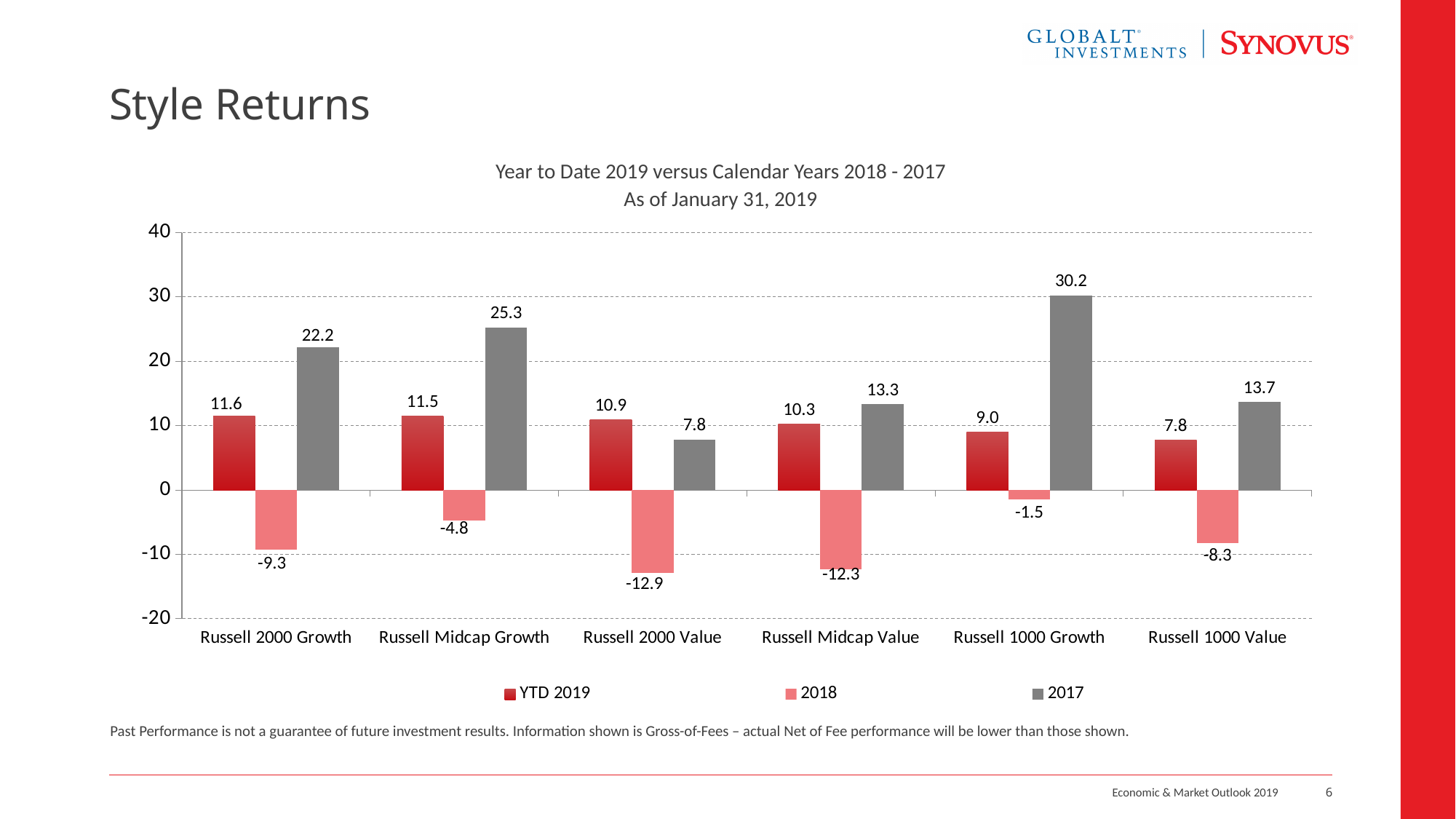
How many categories are shown on the x axis? 6 Which category has the highest 2017 value? Russell 1000 Growth What is the 2017 value for Russell 1000 Growth? 30.2 What kind of chart is shown on the slide? Bar chart What is the YTD 2019 value for Russell 2000 Growth? 11.6 Which category has the lowest YTD 2019 value? Russell 1000 Value What is the difference between the 2017 values for Russell Midcap Growth and Russell 2000 Value? 17.5 What is the 2018 value for Russell 2000 Value? -12.9 What is the chart's title? Year to Date 2019 versus Calendar Years 2018 - 2017 As of January 31, 2019 Which category has the lowest 2018 value? Russell 2000 Value Which is larger, the 2017 value for Russell Midcap Value or the 2017 value for Russell 1000 Value? Russell 1000 Value How many series does the legend list? 3